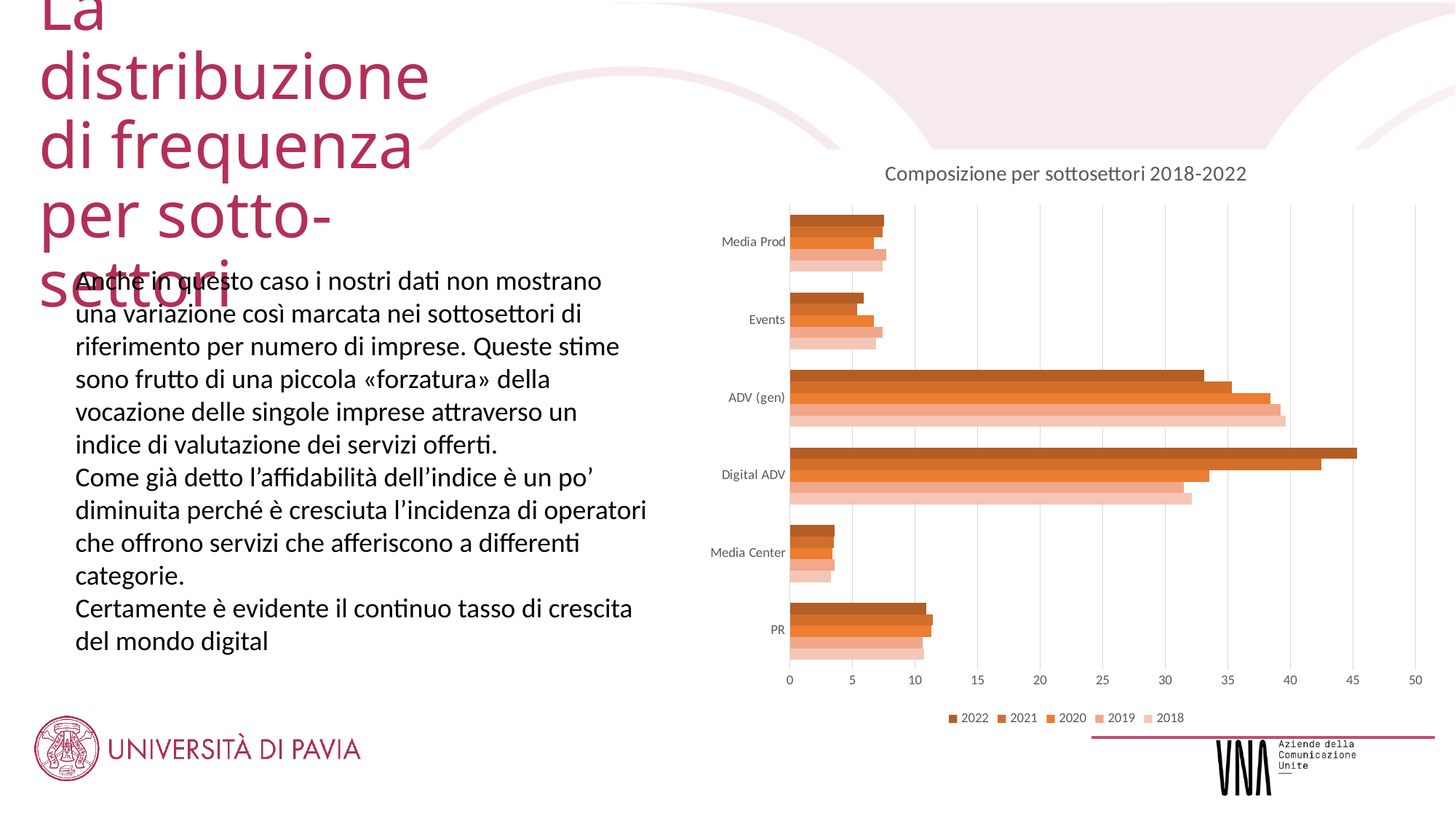
Do the values for Digital ADV rise or fall from 2018 to 2022? rise What kind of chart is shown on the slide? bar chart Is the value for Digital ADV in 2022 greater or less than 40? greater Which category has the highest value for 2022? Digital ADV How many sub-sector categories are shown on the chart? 6 Is the value for Media Center in 2022 greater or less than 5? less Is the value for ADV (gen) in 2022 greater or less than 35? less What is the title of the chart? Composizione per sottosettori 2018-2022 How many series does the chart legend list? 5 For 2018, which is larger: ADV (gen) or Digital ADV? ADV (gen) Which category has the lowest value for 2022? Media Center